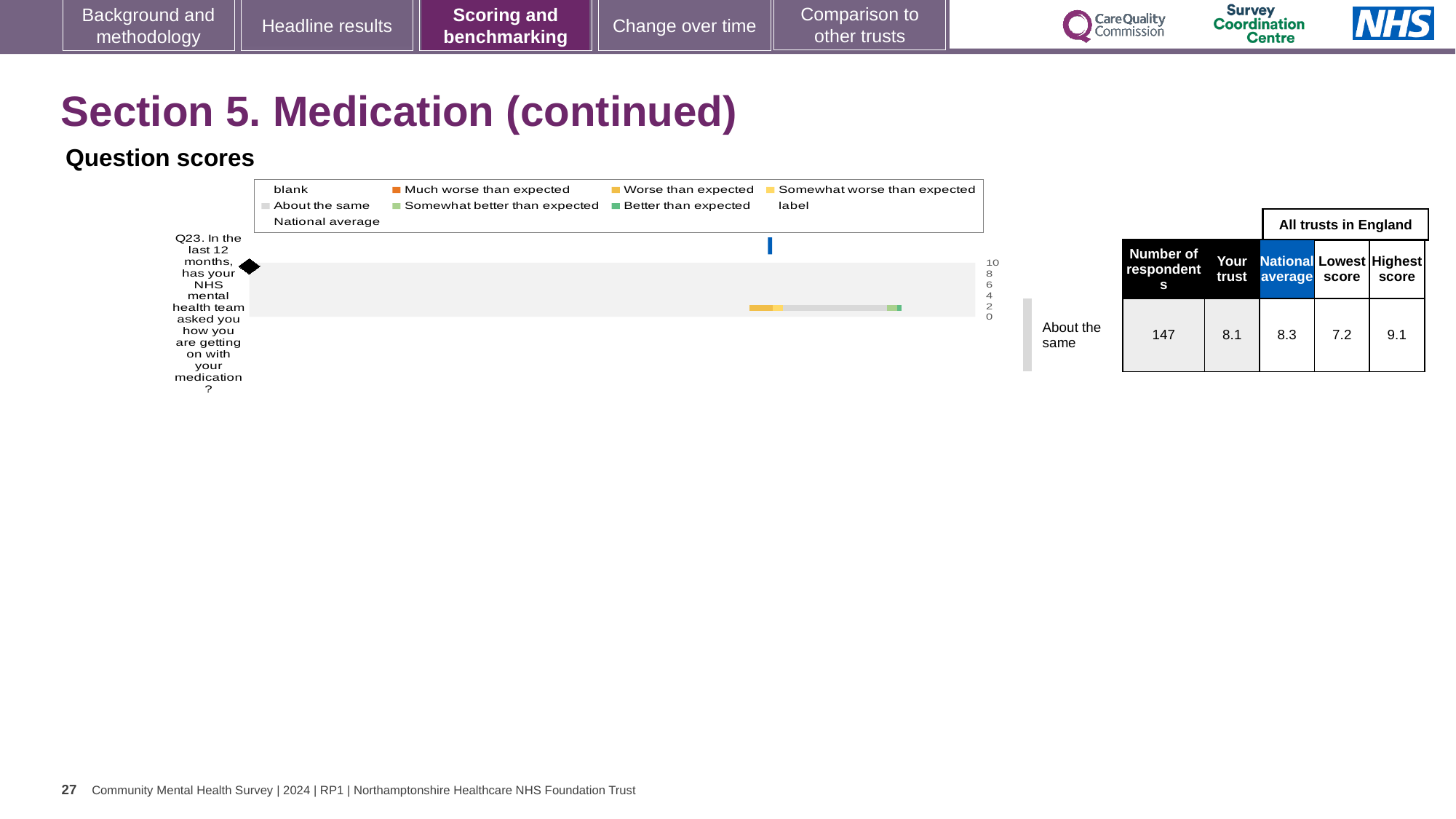
What is the 'Your trust' score for Q23 in the table beside the chart? 8.1 What is the highest score among all trusts in England for Q23? 9.1 What benchmark category is shown next to the Q23 bar in the Question scores chart? About the same What colour represents 'Much worse than expected' in the chart legend? orange What is the lowest score among all trusts in England for Q23? 7.2 What is the number of respondents for Q23 shown in the table beside the chart? 147 Which question number is plotted in the Question scores chart? Q23 What is the national average score for Q23 in the table beside the chart? 8.3 Which is larger for Q23, the 'Your trust' score or the national average? National average How many survey questions are plotted in the Question scores chart? 1 What is the difference between the highest score and the lowest score for Q23? 1.9 What kind of chart is shown under 'Question scores'? bar chart